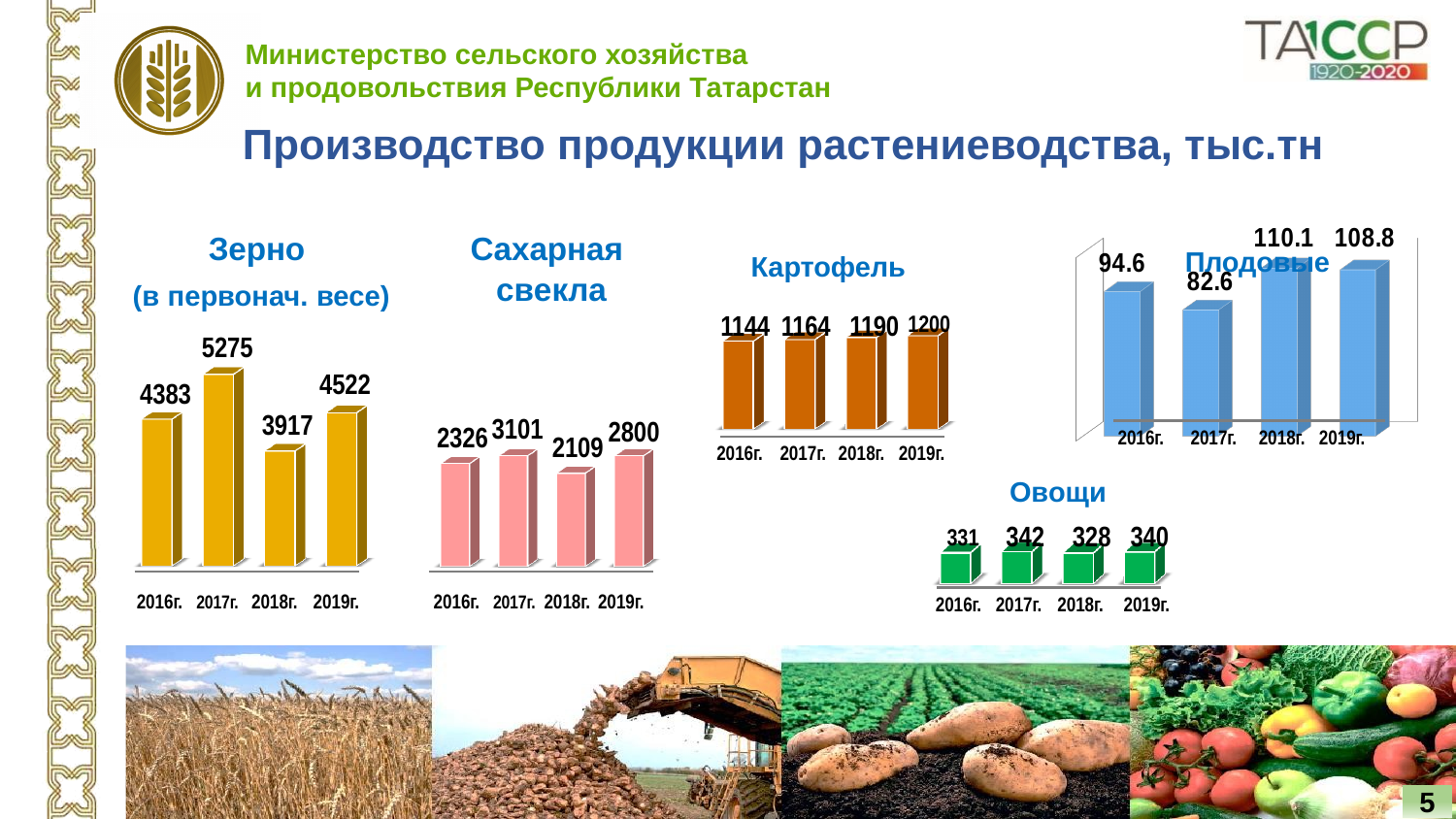
In the Плодовые chart, what is the value for 2017г.? 82.6 In the Сахарная свекла chart, what is the difference between the 2017г. and 2018г. values? 992 In the Плодовые chart, which year has the highest value? 2018г. In the Овощи chart, what is the value for 2016г.? 331 In the Овощи chart, which is larger, the value for 2017г. or the value for 2019г.? 2017г. In the Сахарная свекла chart, what is the value for 2019г.? 2800 In the Зерно chart, which year has the lowest value? 2018г. In the Картофель chart, do the values rise or fall from 2016г. to 2019г.? rise How many bars does the Зерно chart have? 4 In the Картофель chart, what is the value for 2018г.? 1190 What kind of chart is the Картофель chart? bar chart In the Зерно chart, what is the value for 2017г.? 5275